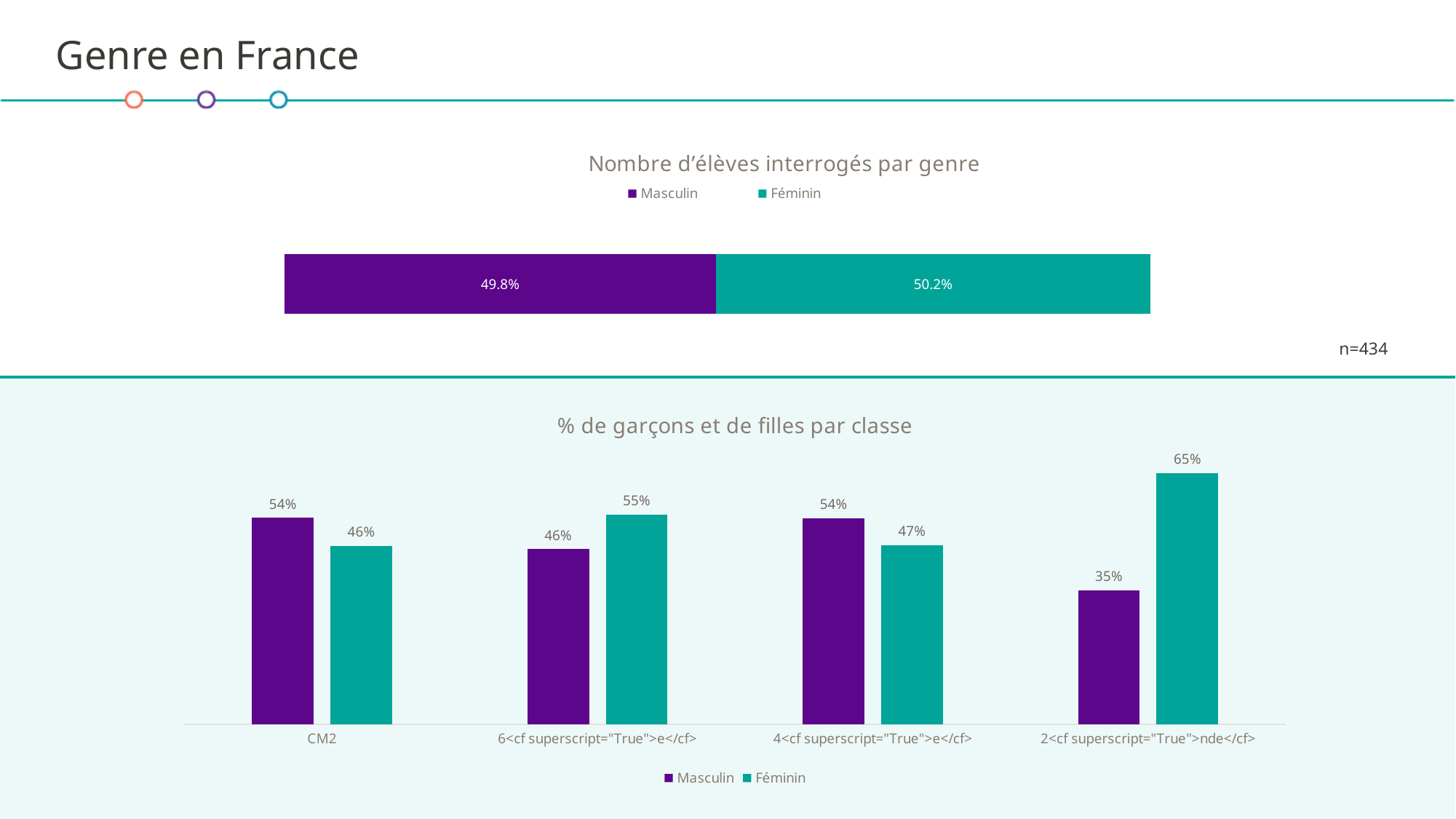
In the chart '% de garçons et de filles par classe', how many categories are shown on the x axis? 4 In the chart '% de garçons et de filles par classe', which category has the lowest Masculin value? 2nde (the last category) In the chart '% de garçons et de filles par classe', what is the Masculin value for the last category (2nde)? 35% In the chart '% de garçons et de filles par classe', what is the difference between the Féminin and Masculin values for the last category (2nde)? 30% In the chart '% de garçons et de filles par classe', what is the Masculin value for CM2? 54% In the chart '% de garçons et de filles par classe', what is the Féminin value for CM2? 46% In the chart 'Nombre d'élèves interrogés par genre', what is the value for Masculin? 49.8% In the chart '% de garçons et de filles par classe', which category has the highest Féminin value? 2nde (the last category) In the chart 'Nombre d'élèves interrogés par genre', which series has the larger share, Masculin or Féminin? Féminin In the chart '% de garçons et de filles par classe', what is the Féminin value for the last category (2nde)? 65% In the chart 'Nombre d'élèves interrogés par genre', what is the value for Féminin? 50.2% In the chart 'Nombre d'élèves interrogés par genre', how many series does the legend list? 2